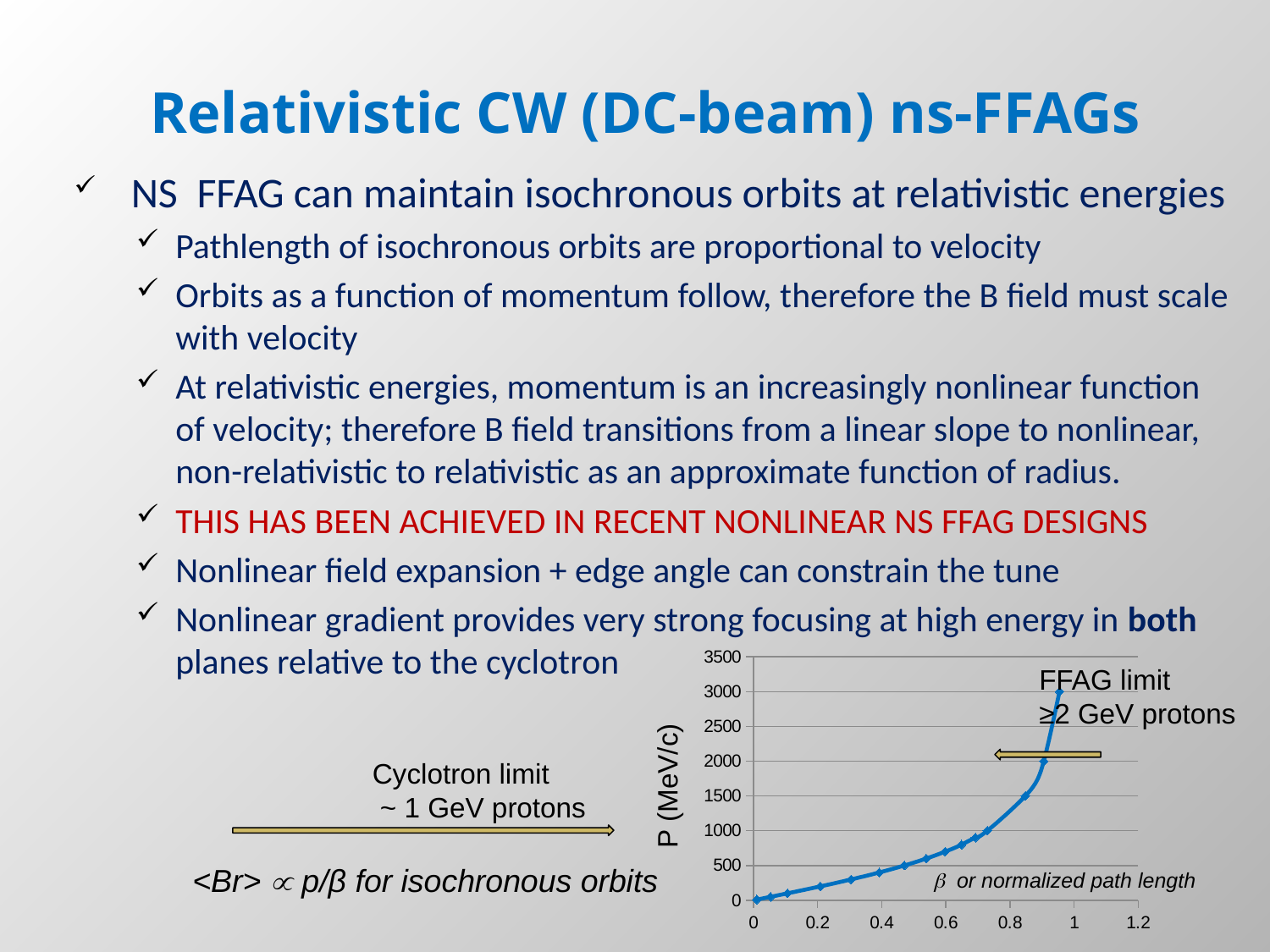
What kind of chart is shown on the slide? line chart What is the highest tick value shown on the vertical axis? 3500 Is the highest plotted value of P greater or less than 2500? greater Does the plotted momentum P rise or fall as β increases along the x axis? rises Is the value of P at β = 0.2 greater or less than 500? less What is the label of the vertical axis of the chart? P (MeV/c) Is the value of P at β = 0.9 greater or less than 1500? greater What is the label of the horizontal axis of the chart? β or normalized path length